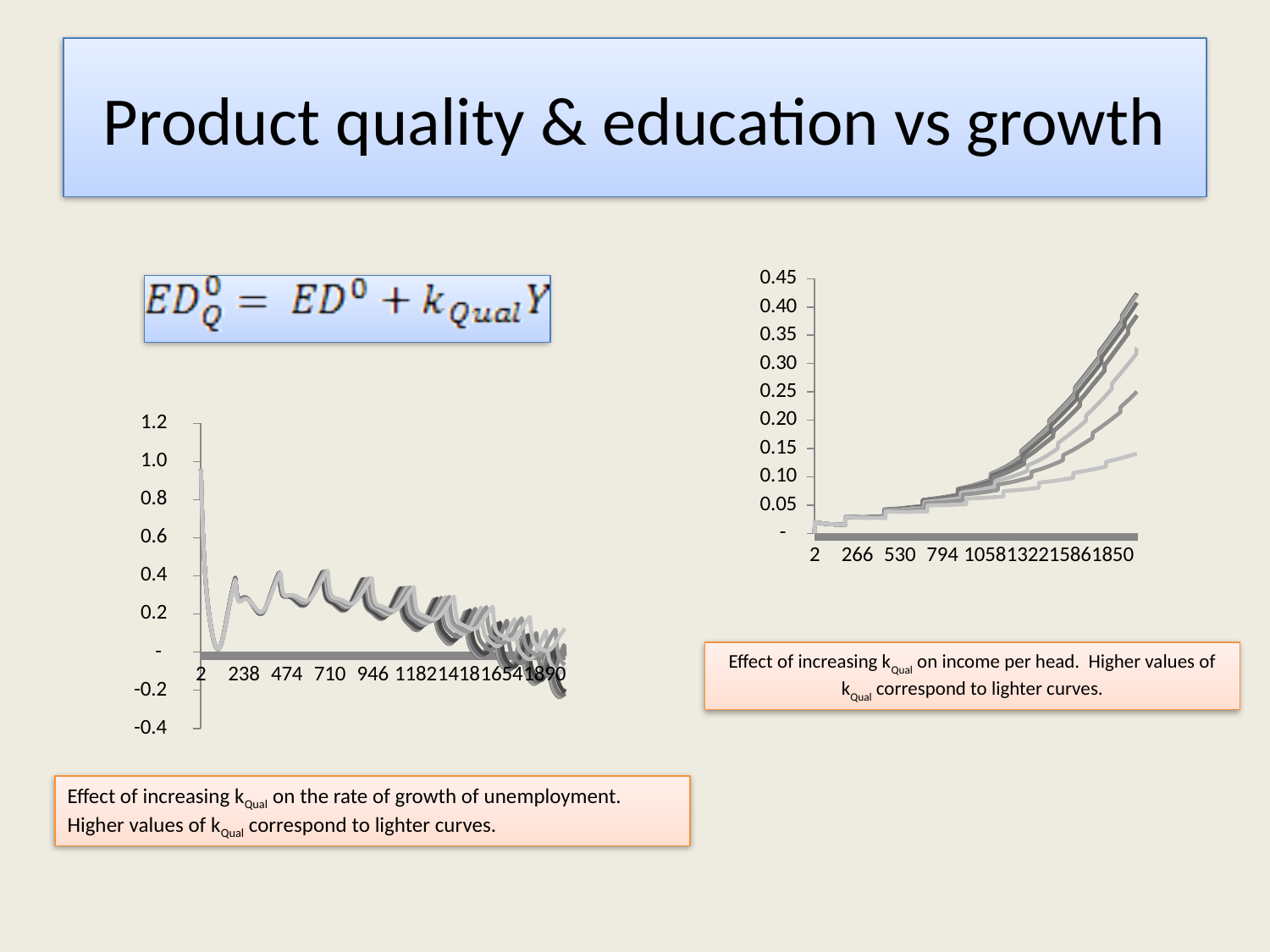
In the chart on the right, are the curves at x = 266 greater or less than 0.10? less In the chart on the right, is the value of the darkest curve at the right end greater or less than 0.35? greater In the chart on the left, is the initial peak near the start of the x axis greater or less than 0.8? greater In the chart on the right, do the curves rise or fall as the x axis increases? rise In the chart on the left, do the curves overall rise or fall along the x axis after the initial spike? fall What kind of chart is the chart on the left of the slide? line chart What is the lowest value shown on the y axis of the chart on the left? -0.4 What is the highest value shown on the y axis of the chart on the right? 0.45 How many tick labels are shown on the x axis of the chart on the right? 8 What kind of chart is the chart on the right of the slide? line chart